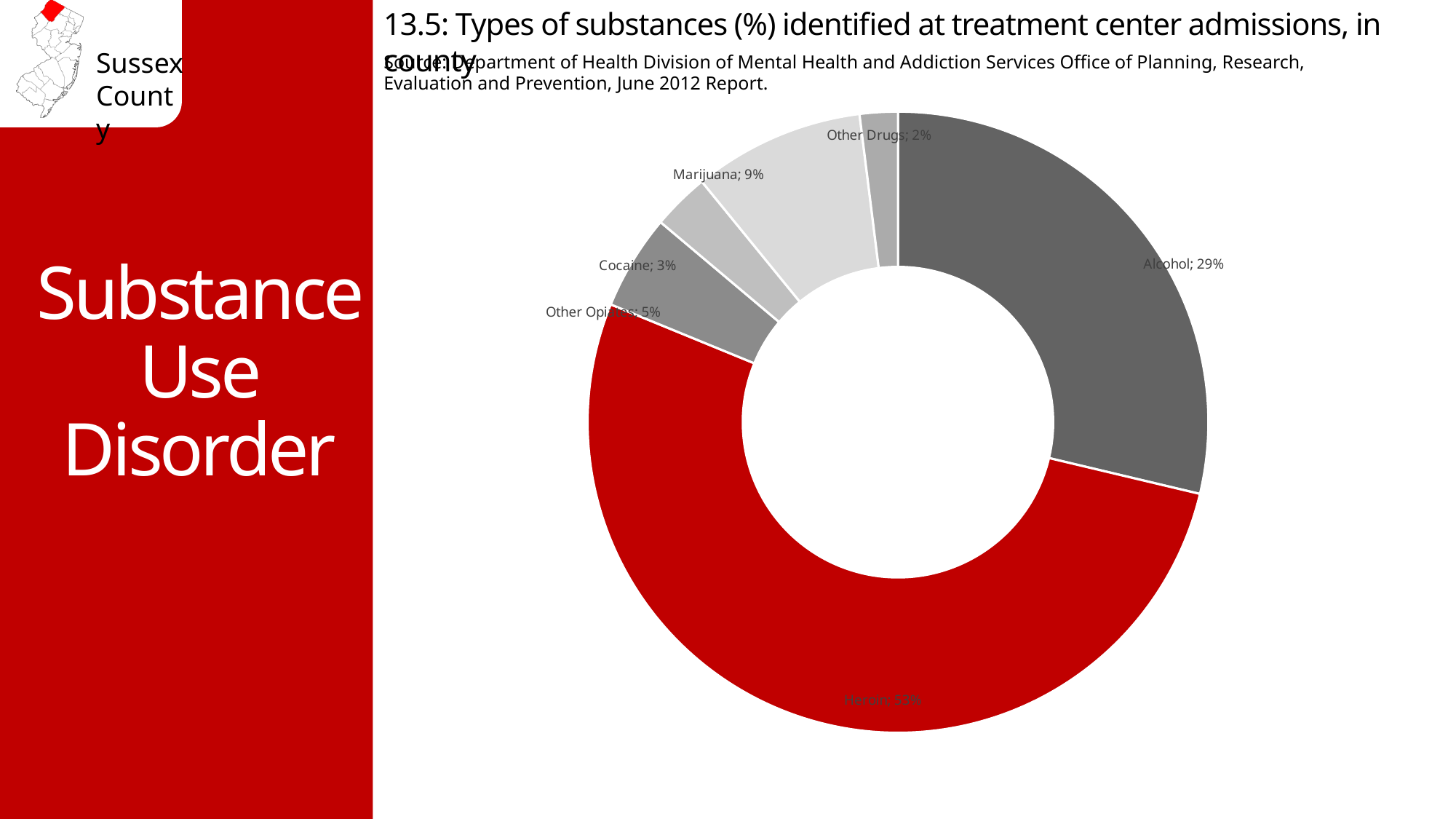
How many substance categories are shown in the chart? 6 What colour is the Heroin slice? Red What percentage is shown for Cocaine? 3% What is the difference in percentage points between Marijuana and Cocaine? 6 What type of chart is used on this slide? Doughnut chart What percentage of treatment center admissions is attributed to Alcohol? 29% Which has a larger share, Alcohol or Marijuana? Alcohol What percentage is shown for Other Drugs? 2% What percentage is shown for Marijuana? 9% Which substance has the smallest share of admissions? Other Drugs Which substance has the largest share of admissions? Heroin What percentage is shown for Other Opiates? 5%